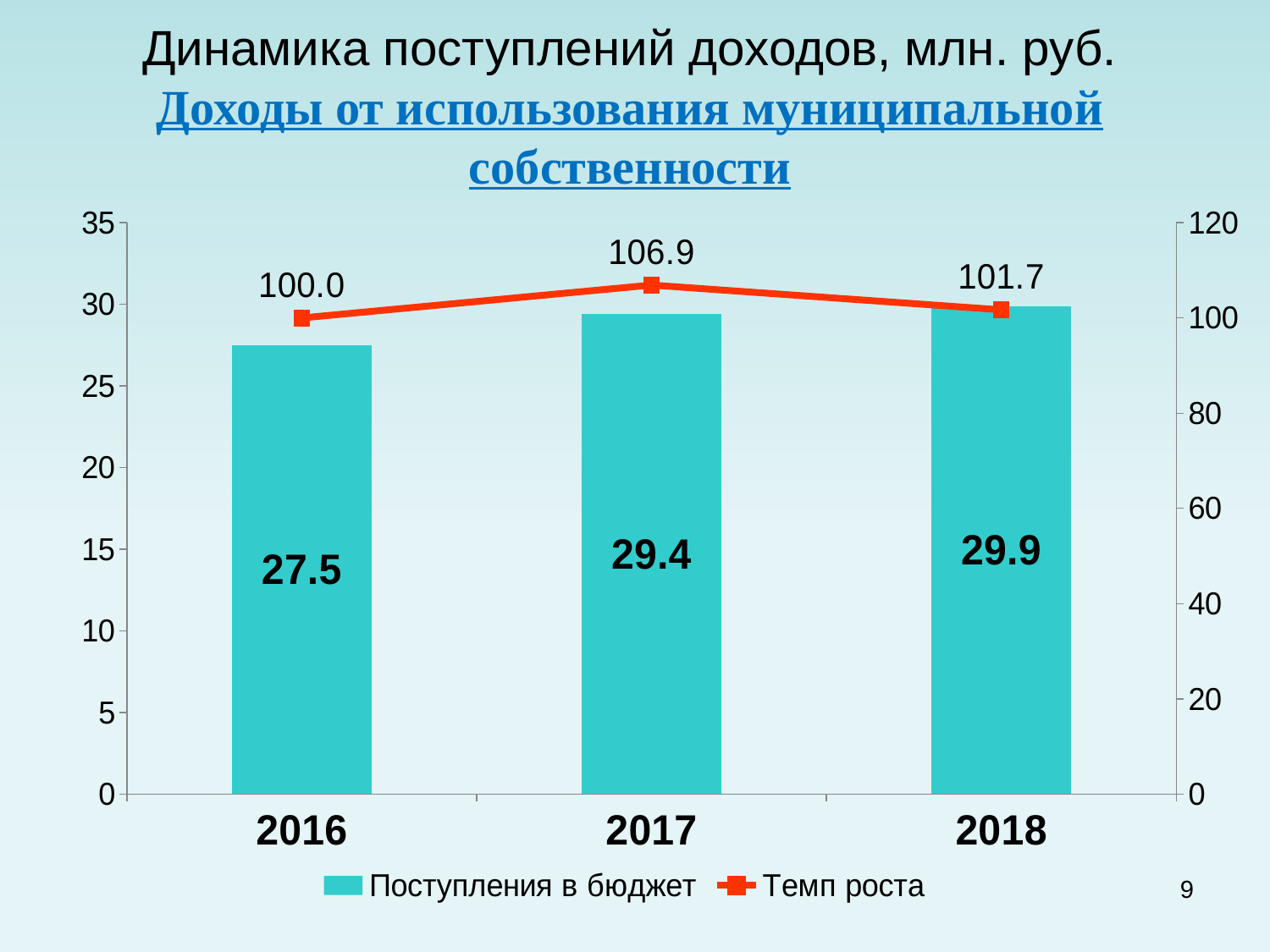
Which year has the highest Поступления в бюджет value? 2018 What colour are the Поступления в бюджет bars? Turquoise What is the value of Поступления в бюджет for 2018? 29.9 What is the difference between the Поступления в бюджет values for 2018 and 2016? 2.4 What is the Темп роста value for 2018? 101.7 Which year has the lowest Темп роста value? 2016 Do the Поступления в бюджет values rise or fall from 2016 to 2018? rise What is the Темп роста value for 2017? 106.9 What is the value of Поступления в бюджет for 2016? 27.5 Which is larger, the Темп роста value for 2017 or for 2018? 2017 How many series does the legend list? 2 How many years are shown on the x axis? 3